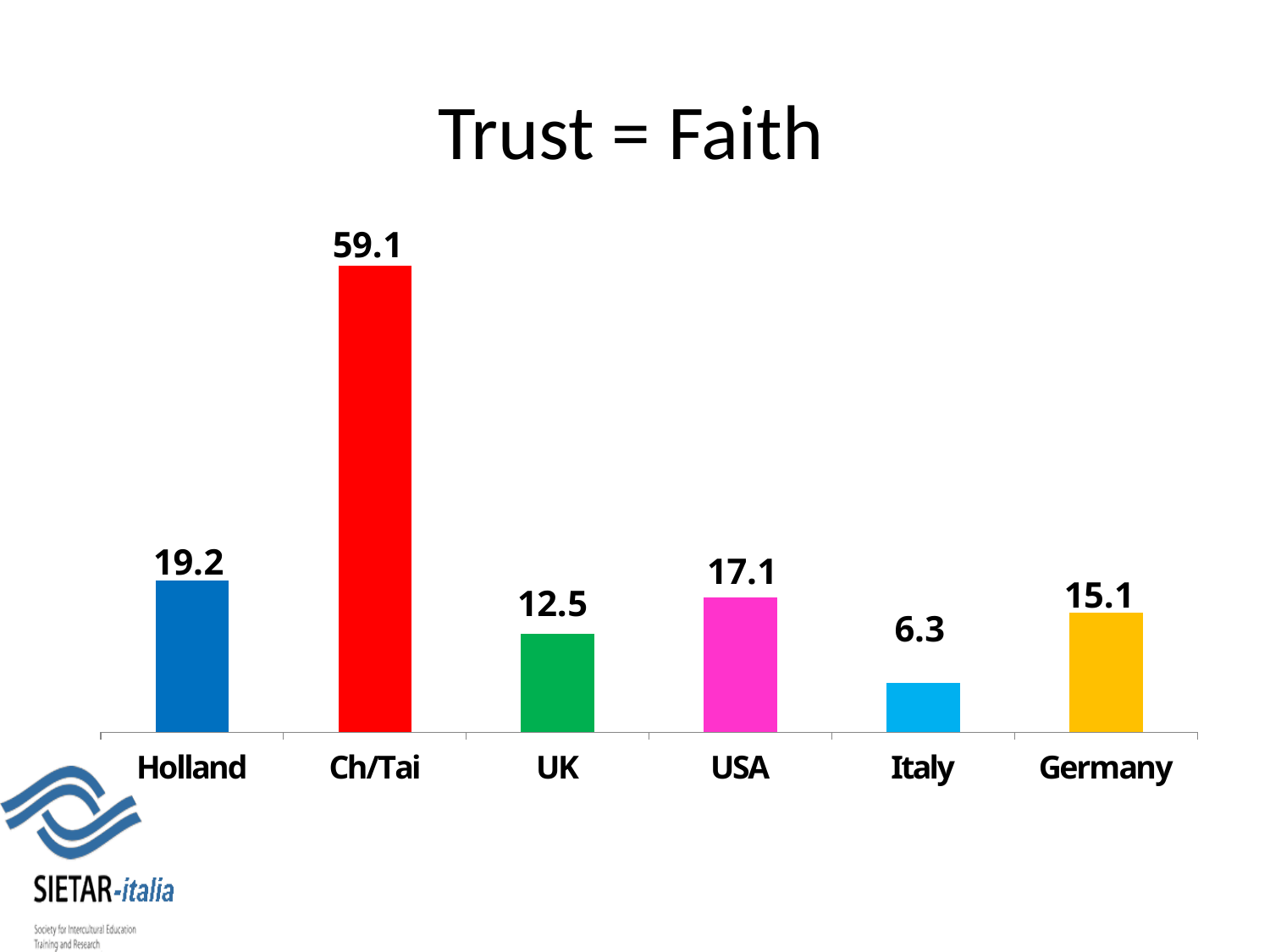
What is the title of the chart? Trust = Faith How many categories are shown on the chart? 6 Which category has the highest value? Ch/Tai What is the value for Ch/Tai? 59.1 What is the value for Germany? 15.1 What kind of chart is shown on the slide? Bar chart What is the difference between the values for USA and UK? 4.6 What is the difference between the values for Ch/Tai and Holland? 39.9 What is the value for Italy? 6.3 Which category has the lowest value? Italy Which is larger, the value for USA or the value for Germany? USA What is the value for Holland? 19.2